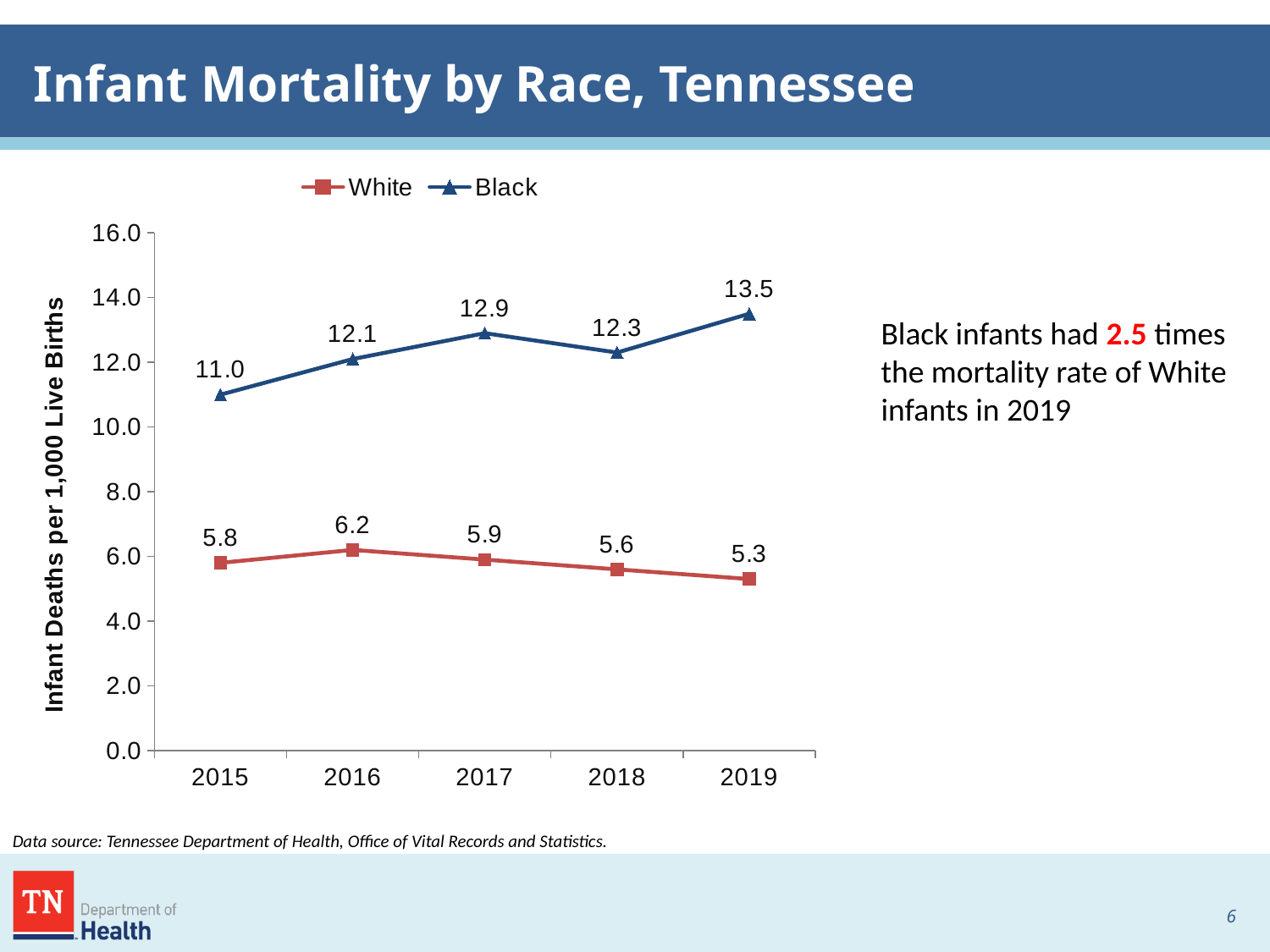
What was the infant mortality rate for Black infants in 2019? 13.5 What was the infant mortality rate for Black infants in 2015? 11.0 What is the difference between the Black and White infant mortality rates in 2019? 8.2 Which series had the higher infant mortality rate in 2018, White or Black? Black How many series does the legend list? 2 Does the White infant mortality rate rise or fall from 2016 to 2019? Fall How many years are shown on the x axis? 5 In which year was the infant mortality rate for Black infants lowest? 2015 In which year was the infant mortality rate for White infants highest? 2016 What kind of chart is shown on the slide? Line chart What is the difference between the Black infant mortality rate in 2017 and in 2018? 0.6 What was the infant mortality rate for White infants in 2016? 6.2